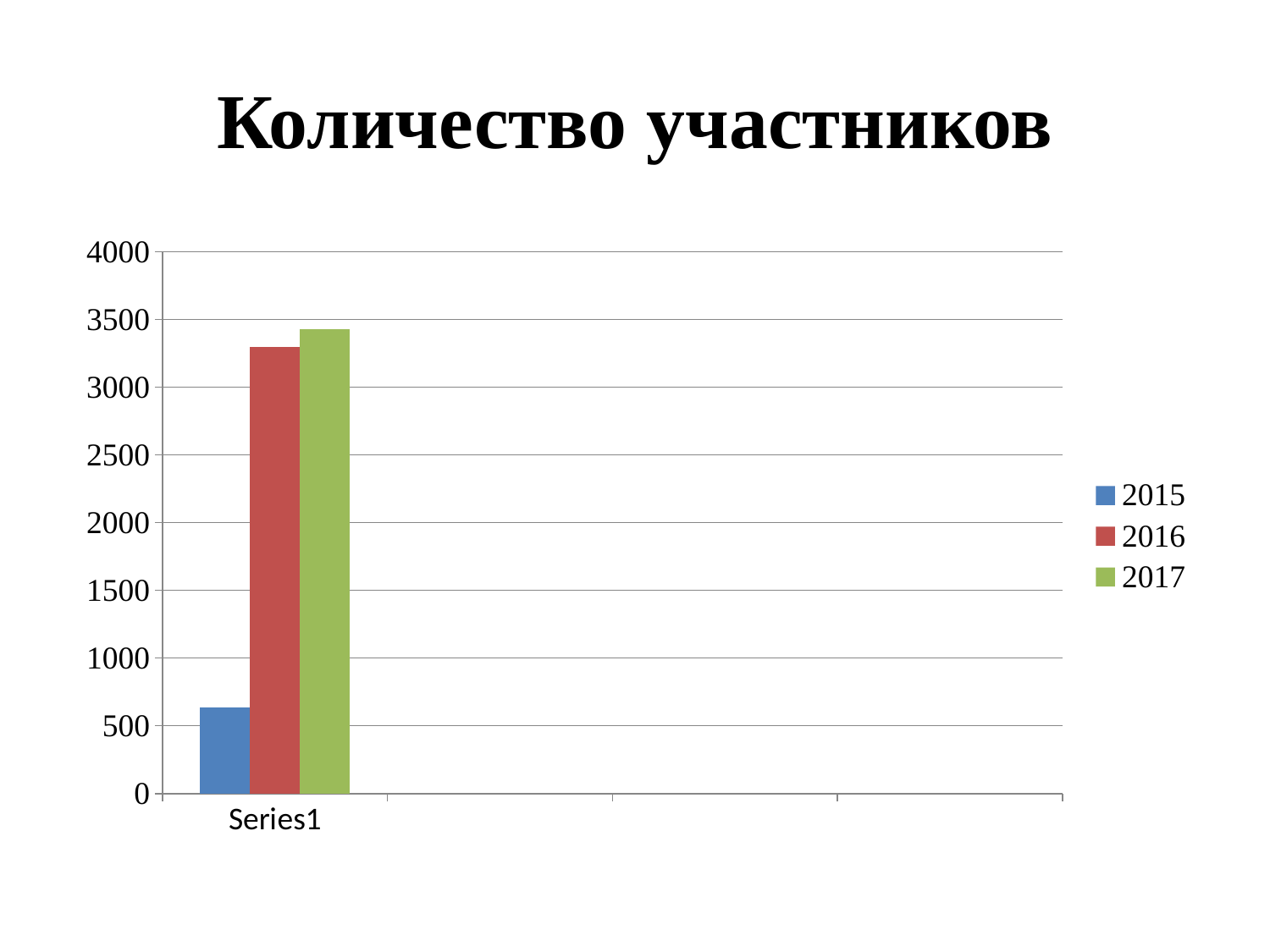
What is the title of the chart? Количество участников What kind of chart is shown on the slide? bar chart Which series has the lowest value? 2015 How many series does the legend list? 3 Is the value for 2017 greater or less than 3500? less Is the value for 2016 greater or less than 3500? less Is the value for 2015 greater or less than 500? greater Which is larger, the value for 2015 or the value for 2016? 2016 Which series does the legend list first? 2015